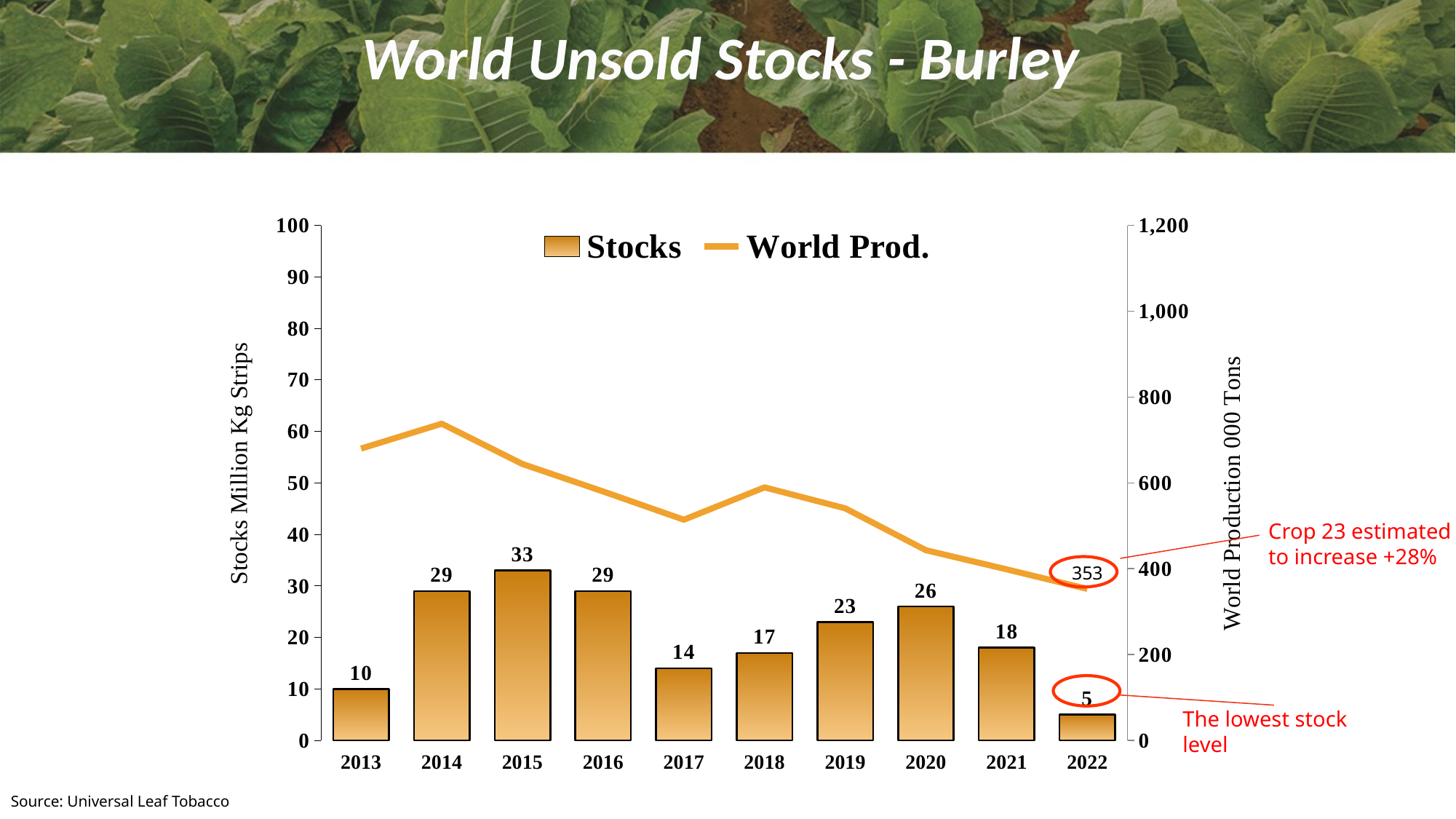
Does the World Prod. line generally rise or fall from 2014 to 2022? Fall What is the difference between the Stocks values for 2020 and 2021? 8 Which year has the lowest Stocks value? 2022 What kind of chart is used for the Stocks series? Bar chart Which year has the larger Stocks value, 2017 or 2019? 2019 How many years are shown on the x axis? 10 Is the World Prod. value for 2014 greater or less than 600? greater What is the World Prod. value for 2022? 353 Which year has the highest Stocks value? 2015 How many series does the legend list? 2 What is the Stocks value for 2015? 33 What is the Stocks value for 2022? 5